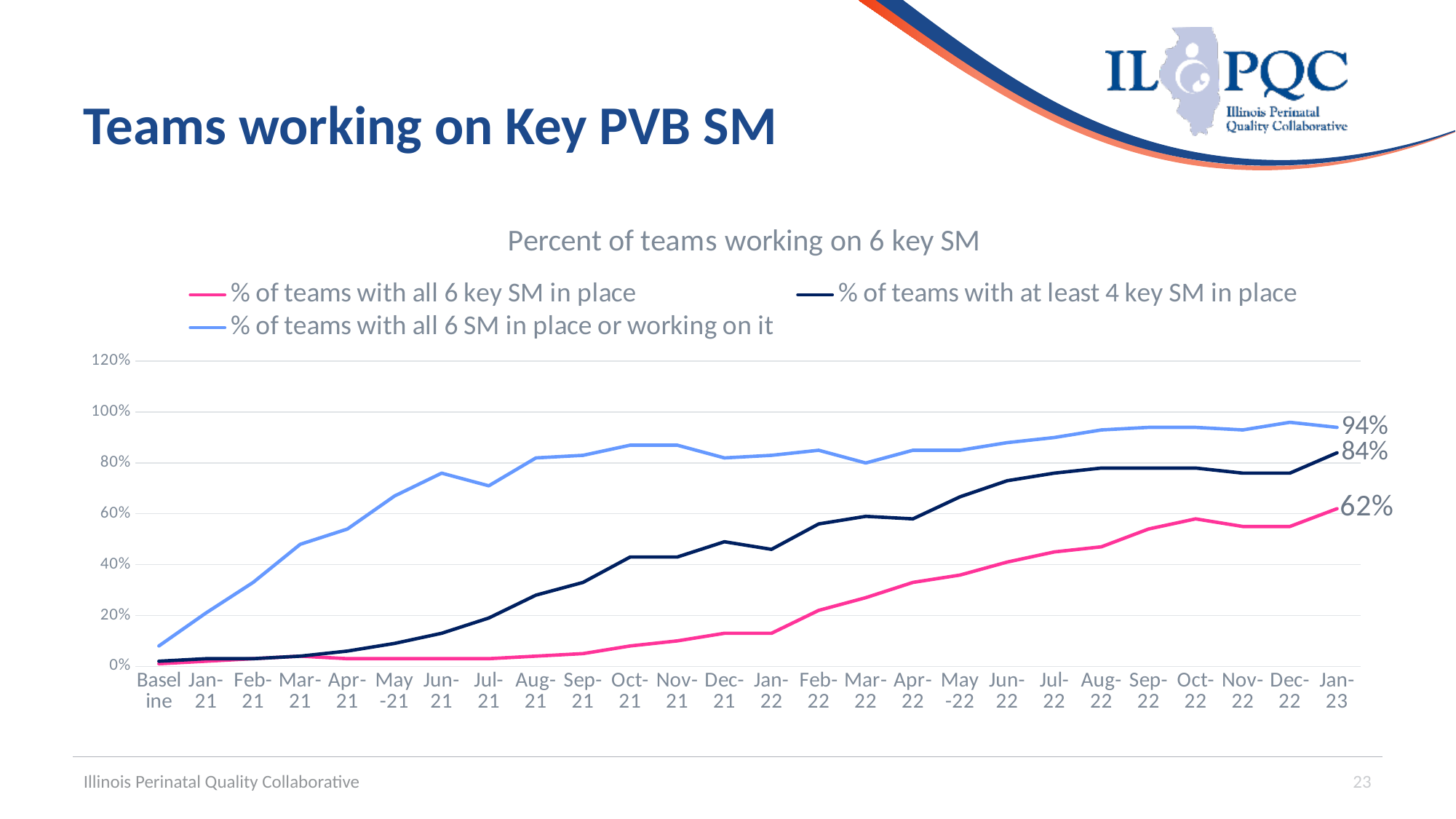
What type of chart is shown on the slide? line chart What is the value for '% of teams with at least 4 key SM in place' at Jan-23? 84% How many series does the legend list? 3 What is the difference between the Jan-23 values for '% of teams with all 6 SM in place or working on it' and '% of teams with all 6 key SM in place'? 32 percentage points Do the values for '% of teams with all 6 key SM in place' generally rise or fall from Baseline to Jan-23? rise At Jan-23, which is larger: '% of teams with at least 4 key SM in place' or '% of teams with all 6 key SM in place'? % of teams with at least 4 key SM in place What is the title of the chart? Percent of teams working on 6 key SM What is the value for '% of teams with all 6 SM in place or working on it' at Jan-23? 94% How many points are plotted along the x axis (including Baseline)? 26 What is the value for '% of teams with all 6 key SM in place' at Jan-23? 62% Which series has the highest value at Jan-23? % of teams with all 6 SM in place or working on it Is the value for '% of teams with all 6 key SM in place' at Jan-22 greater or less than 20%? less